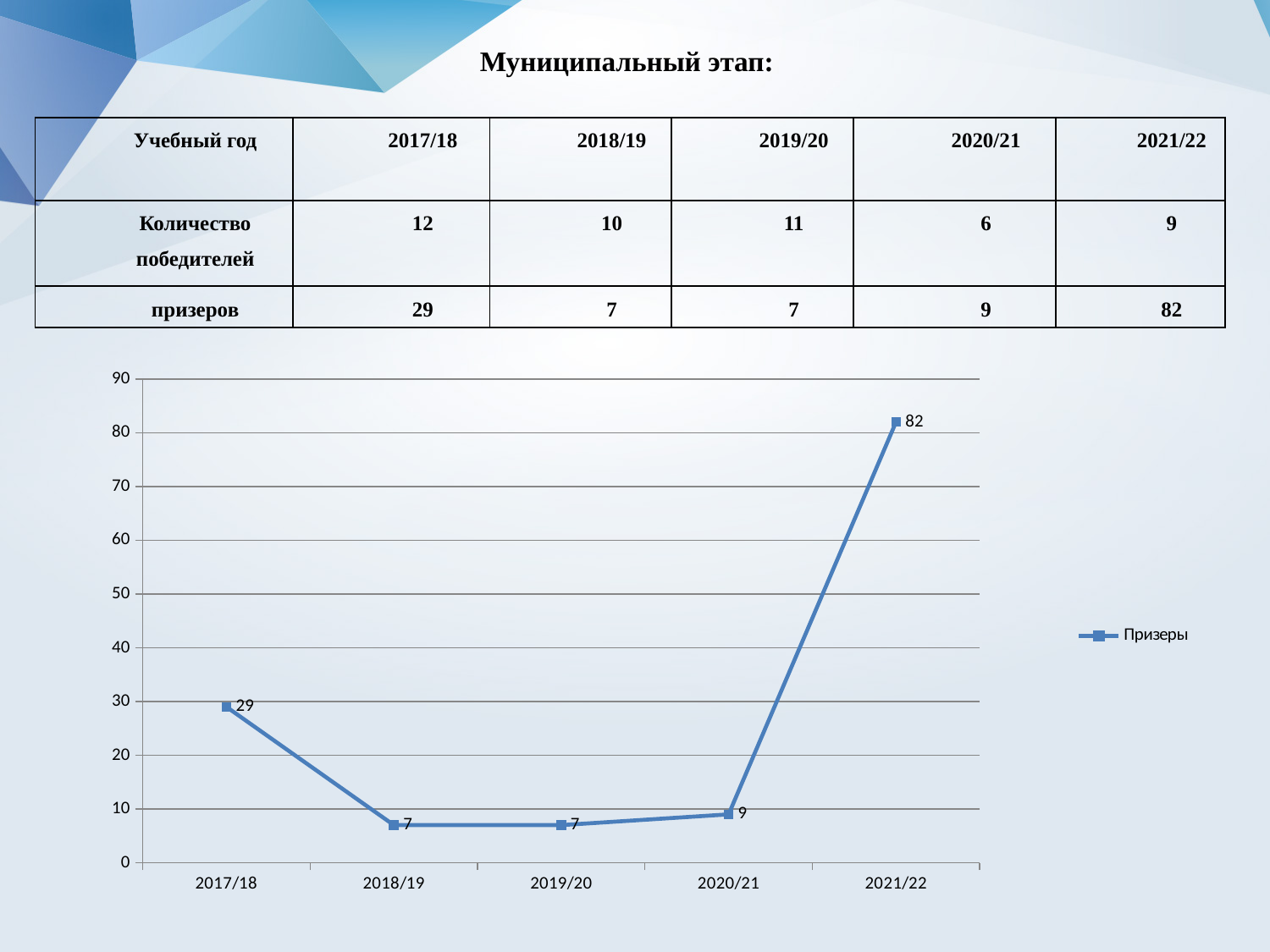
What is the value for 2020/21 in the line chart? 9 What is the difference between the values for 2021/22 and 2017/18? 53 Which year has the highest value in the line chart? 2021/22 What is the value for 2017/18 in the line chart? 29 Is the value for 2021/22 greater or less than 80? greater How many data points are plotted on the line chart? 5 How many series does the legend list? 1 Which is larger, the value for 2017/18 or the value for 2020/21? 2017/18 What is the name of the series shown in the legend? Призеры What type of chart is shown on the slide? line chart What is the difference between the values for 2017/18 and 2018/19? 22 What is the value for 2021/22 in the line chart? 82